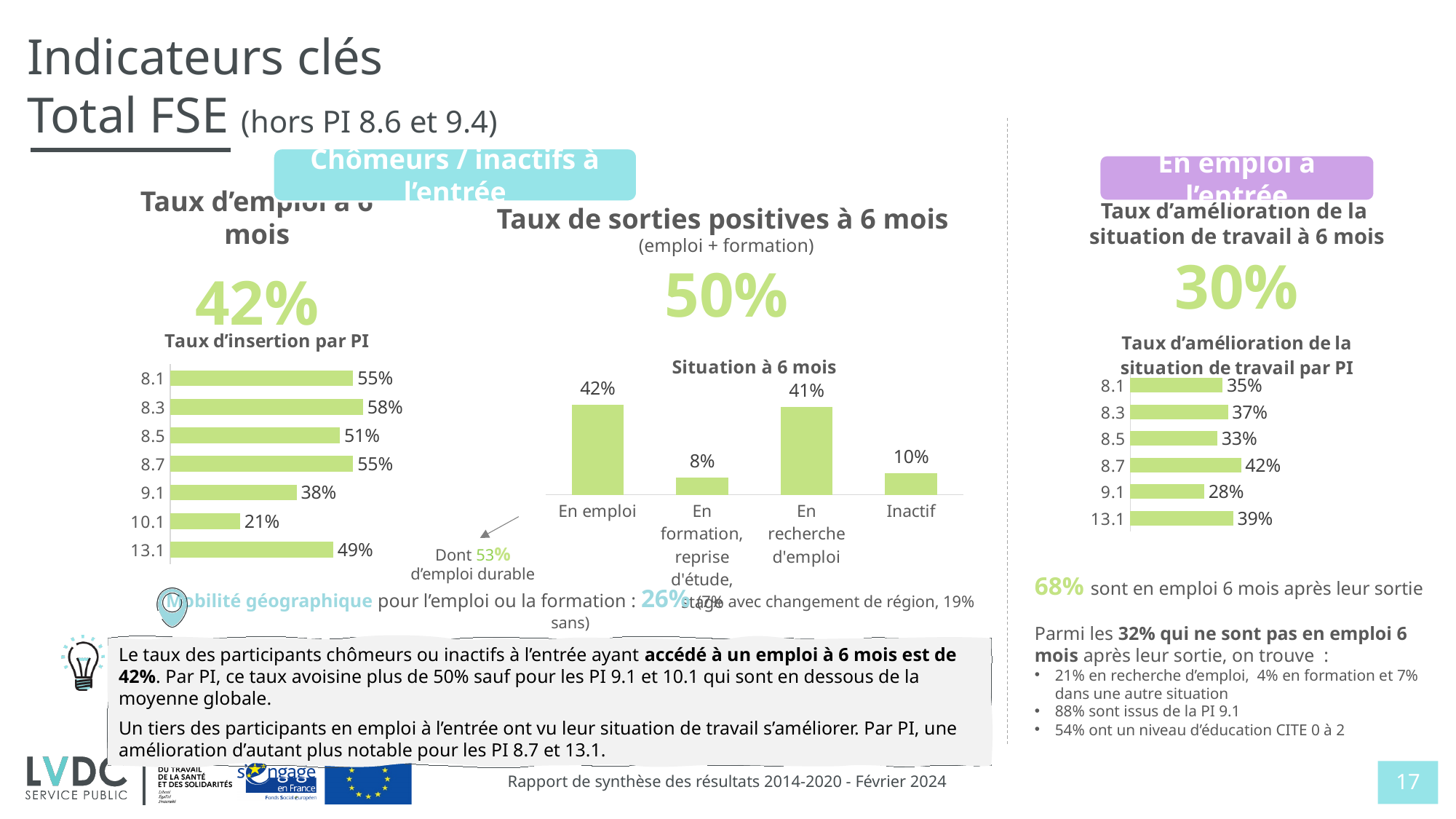
In the 'Taux d'insertion par PI' chart, what is the value for 8.3? 58% In the 'Taux d'insertion par PI' chart, how many PI categories are shown? 7 In the 'Situation à 6 mois' chart, which is larger: 'En recherche d'emploi' or 'Inactif'? En recherche d'emploi In the 'Taux d'amélioration de la situation de travail par PI' chart, what is the difference between the values for 13.1 and 8.5? 6% In the 'Situation à 6 mois' chart, which category has the highest value? En emploi In the 'Taux d'amélioration de la situation de travail par PI' chart, which PI has the lowest value? 9.1 What kind of chart is 'Situation à 6 mois'? Bar chart In the 'Taux d'insertion par PI' chart, what is the difference between the values for 8.1 and 9.1? 17% In the 'Situation à 6 mois' chart, what is the value for 'En formation, reprise d'étude, stage'? 8% In the 'Taux d'insertion par PI' chart, which PI has the highest value? 8.3 In the 'Taux d'amélioration de la situation de travail par PI' chart, what is the value for 8.7? 42% In the 'Taux d'insertion par PI' chart, which PI has the lowest value? 10.1